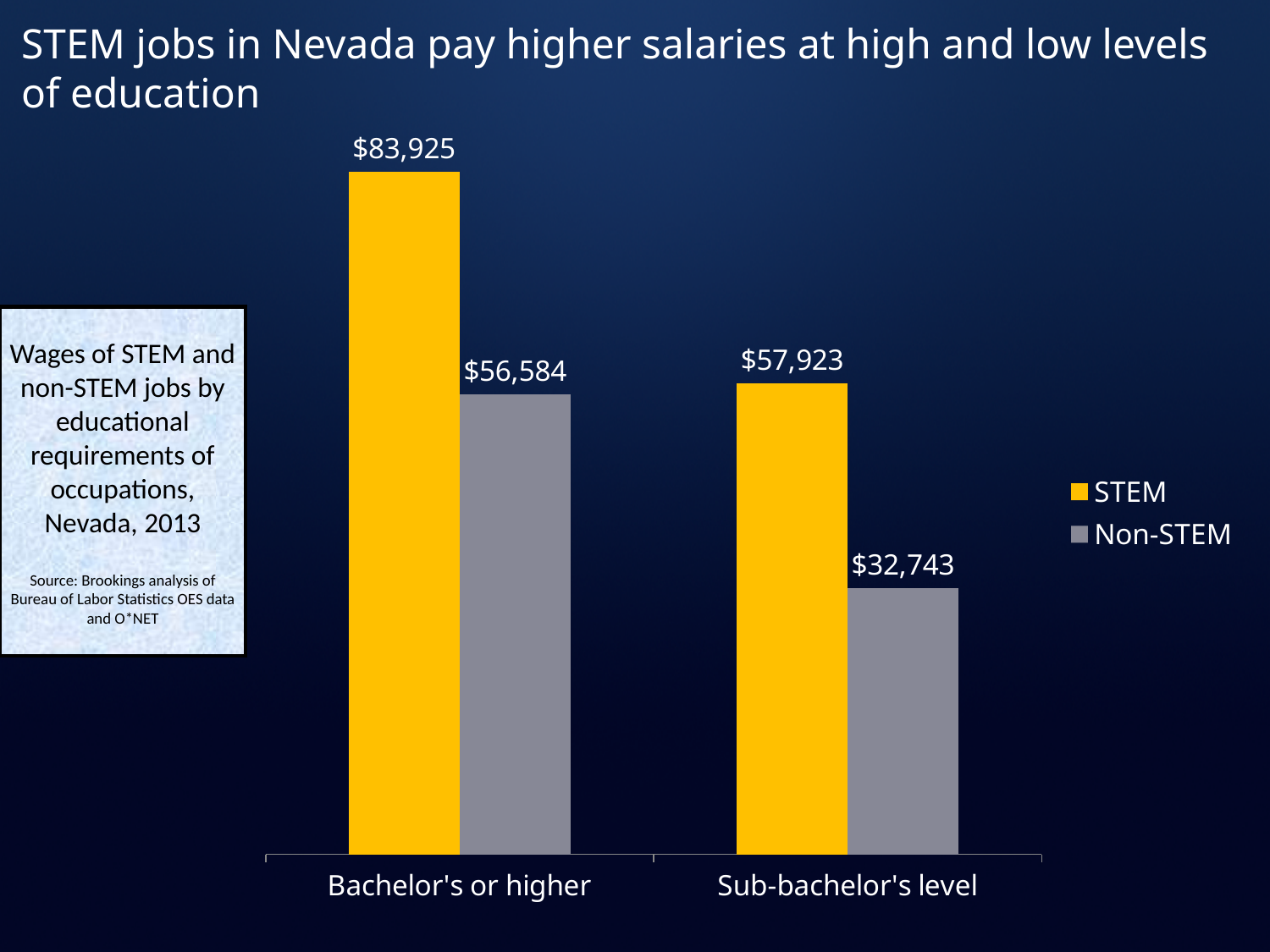
What kind of chart is shown on the slide? Bar chart What is the Non-STEM wage for Sub-bachelor's level? $32,743 What is the Non-STEM wage for Bachelor's or higher? $56,584 Which bar shows the highest wage on the chart? STEM, Bachelor's or higher Which bar shows the lowest wage on the chart? Non-STEM, Sub-bachelor's level How many series does the legend list? 2 What is the difference between the STEM and Non-STEM wages for Bachelor's or higher? $27,341 What is the STEM wage for Bachelor's or higher? $83,925 What is the difference between the STEM and Non-STEM wages for Sub-bachelor's level? $25,180 Which is larger: the STEM wage at Sub-bachelor's level or the Non-STEM wage at Bachelor's or higher? STEM wage at Sub-bachelor's level How many education categories are shown on the x axis? 2 What is the STEM wage for Sub-bachelor's level? $57,923